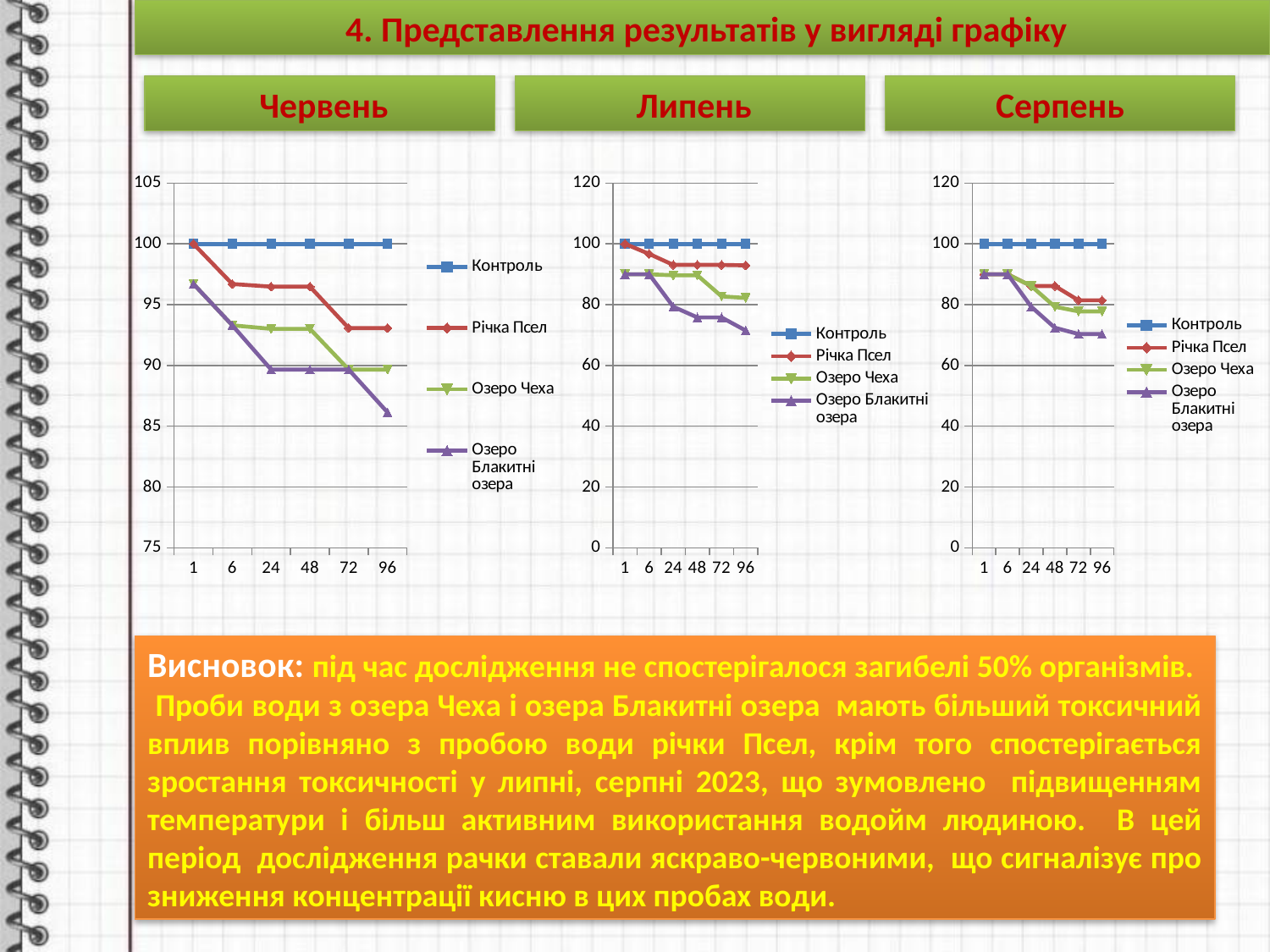
In the Червень chart, what is the value of Контроль at 96? 100 How many points are on the x axis of the Серпень chart? 6 What kind of chart is the Червень chart? line chart In the Червень chart, is the value for Озеро Блакитні озера at 96 greater or less than 90? less In the Червень chart, do the values for Озеро Блакитні озера rise or fall along the x axis? fall How many series does the legend of the Липень chart list? 4 In the Серпень chart, what is the value of Контроль at 1? 100 In the Липень chart, is the value for Озеро Блакитні озера at 96 greater or less than 80? less In the Липень chart, is the value for Річка Псел at 96 greater or less than 80? greater In the Серпень chart, which is larger at 96: Річка Псел or Озеро Блакитні озера? Річка Псел In the Червень chart, which series has the lowest value at 96? Озеро Блакитні озера In the Липень chart, which series has the highest value at 96? Контроль